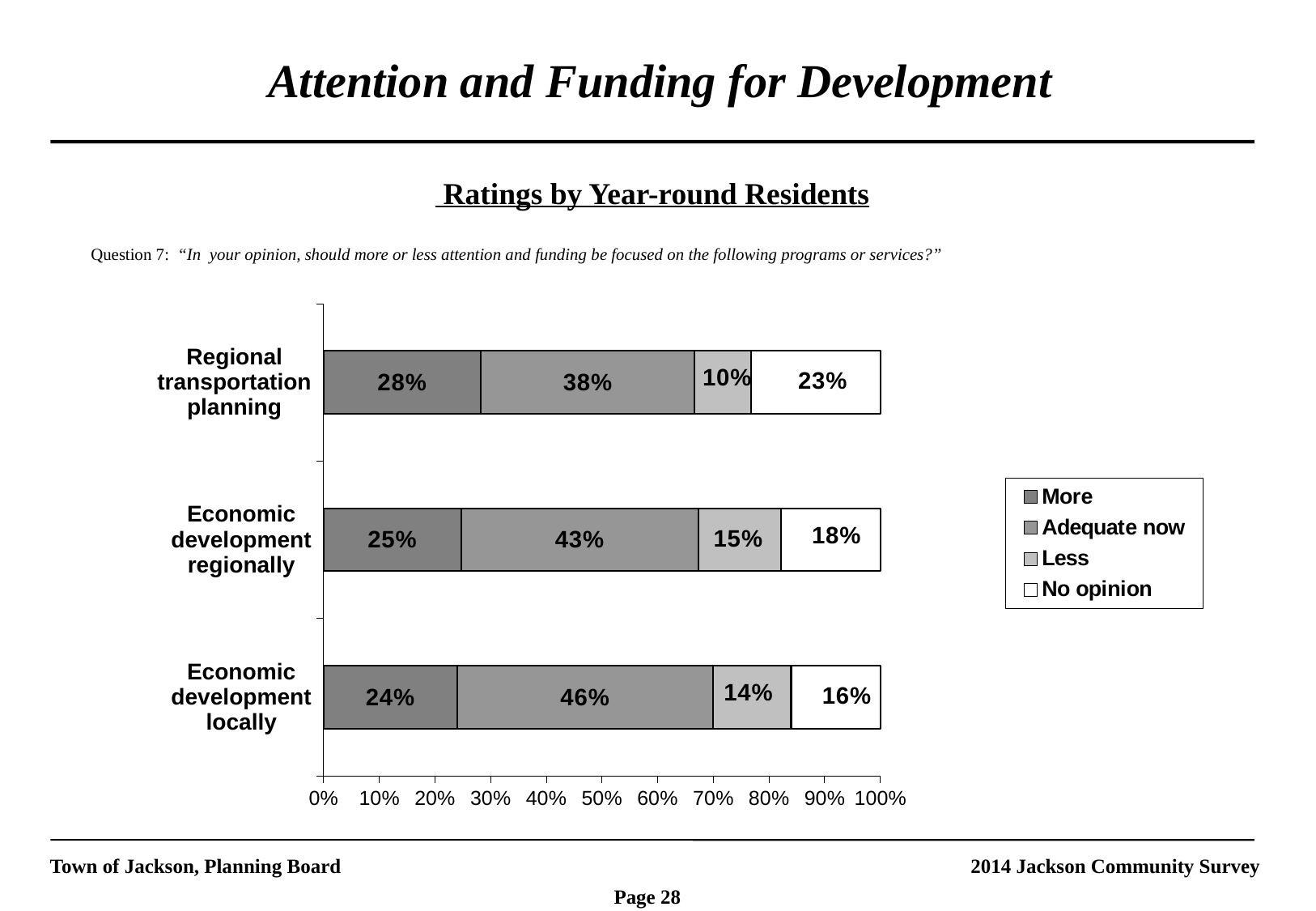
How many series does the legend list? 4 What is the "No opinion" value for Economic development regionally? 18% Which category has the highest "Adequate now" percentage? Economic development locally How many categories are shown on the chart? 3 What is the difference between the "Adequate now" values for Economic development locally and Regional transportation planning? 8% What kind of chart is shown on the slide? Stacked bar chart Which category has the lowest "No opinion" percentage? Economic development locally What is the "Less" value for Regional transportation planning? 10% What percentage of year-round residents said "More" for Regional transportation planning? 28% Which is larger: the "Less" value for Economic development regionally or for Economic development locally? Economic development regionally What percentage said "Adequate now" for Economic development locally? 46% What is the total of the stacked bar for Economic development locally? 100%